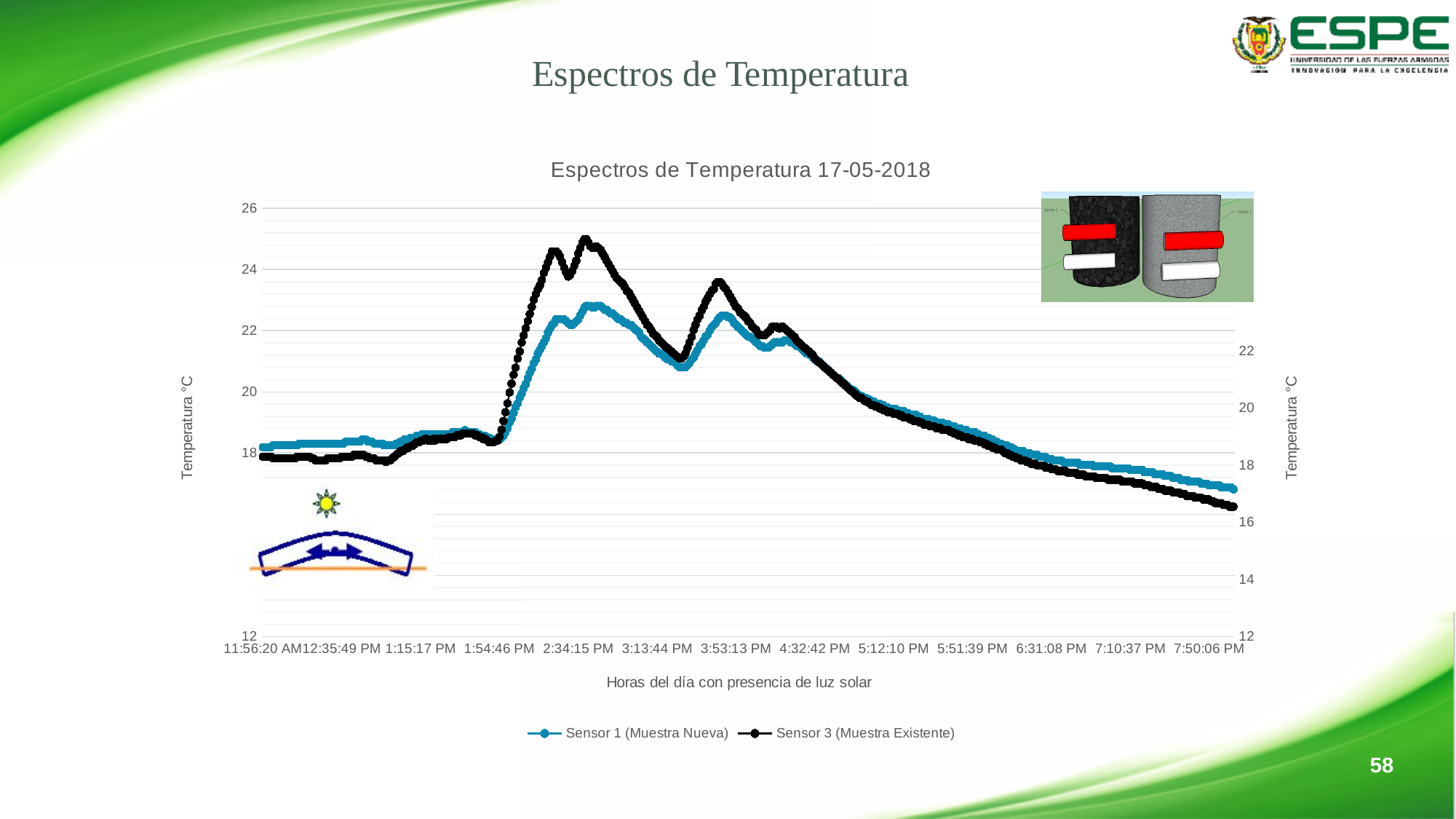
Is the value of Sensor 3 (Muestra Existente) at 7:50:06 PM greater or less than 18? less What are the two series named in the chart legend? Sensor 1 (Muestra Nueva) and Sensor 3 (Muestra Existente) Do the temperature values rise or fall between 1:54:46 PM and 2:34:15 PM? Rise Is the value of Sensor 1 (Muestra Nueva) at 11:56:20 AM greater or less than 18? greater Is the highest value reached by Sensor 1 (Muestra Nueva) greater or less than 24? less What kind of chart is shown on the slide? Line chart How many series does the chart legend list? 2 Do the temperature values rise or fall between 4:32:42 PM and 7:50:06 PM? Fall Which series reaches the higher peak around 2:34:15 PM, Sensor 1 (Muestra Nueva) or Sensor 3 (Muestra Existente)? Sensor 3 (Muestra Existente) What is the title of the chart? Espectros de Temperatura 17-05-2018